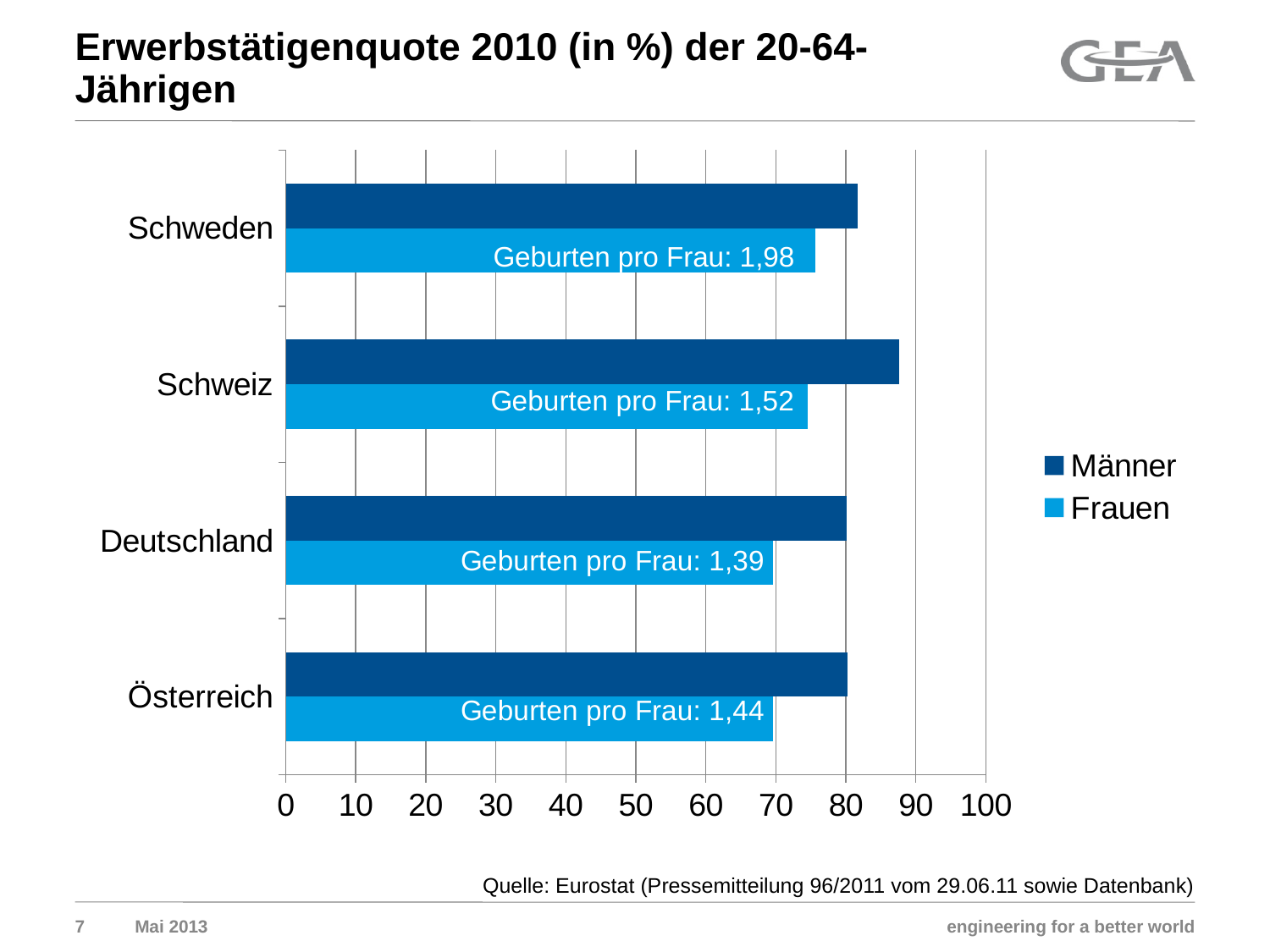
Which is larger for Schweiz: the Männer value or the Frauen value? Männer Is the Frauen value for Schweden greater or less than 70? greater How many countries are shown on the chart? 4 Is the Männer value for Schweiz greater or less than 80? greater Which is larger: the Männer value for Schweiz or the Männer value for Schweden? Schweiz How many series does the legend list? 2 What kind of chart is shown on the slide? bar chart What value of 'Geburten pro Frau' is printed for Deutschland? 1,39 Which series are listed in the legend? Männer, Frauen Is the Frauen value for Österreich greater or less than 80? less Which country has the highest value for Männer? Schweiz